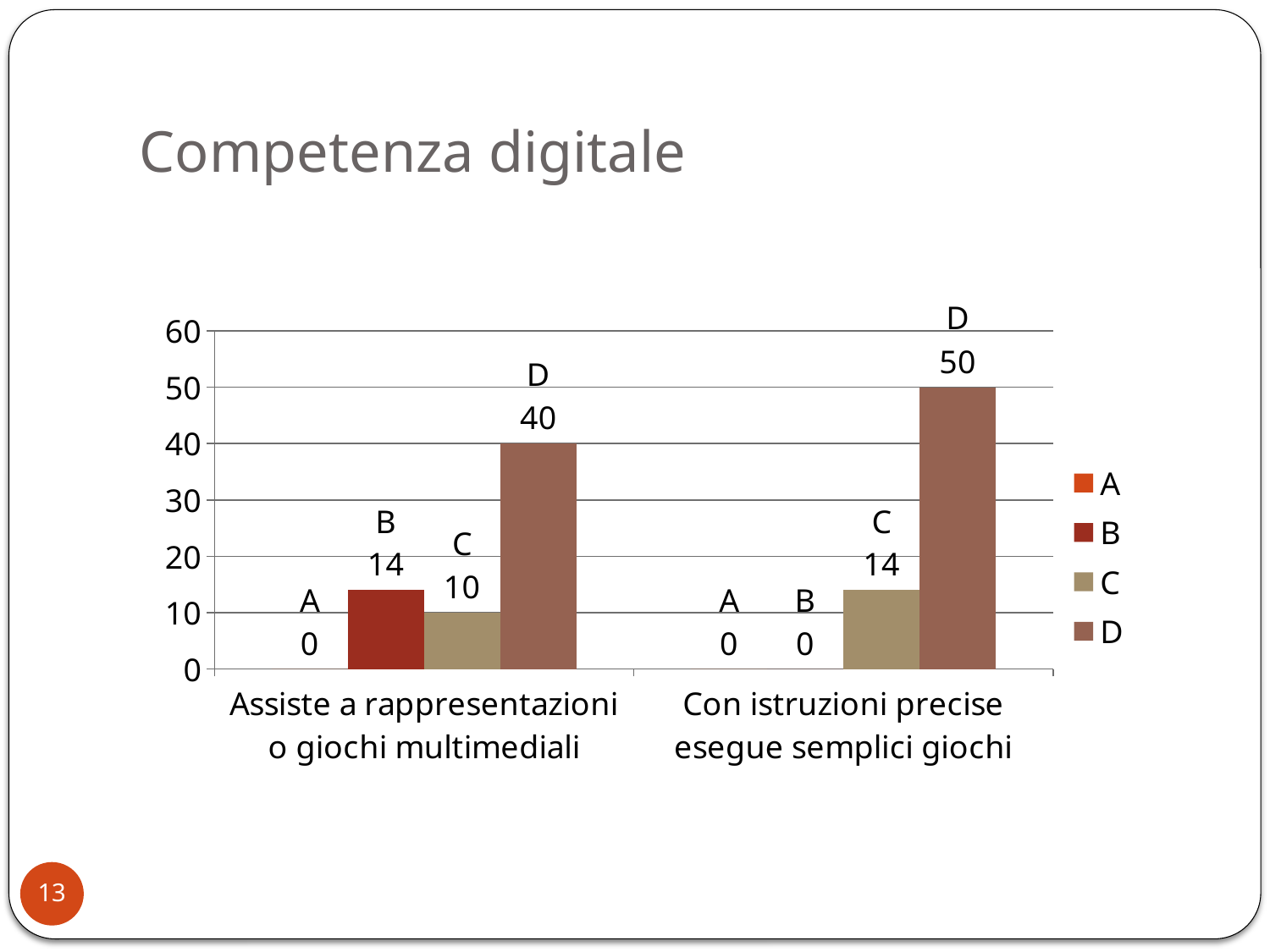
How many series does the legend list? 4 What is the value for series C in the category "Con istruzioni precise esegue semplici giochi"? 14 What is the title of the slide? Competenza digitale Which series has the highest value in the category "Con istruzioni precise esegue semplici giochi"? D What is the value for series D in the category "Assiste a rappresentazioni o giochi multimediali"? 40 What kind of chart is shown on the slide? bar chart Is the value for D in "Con istruzioni precise esegue semplici giochi" greater or less than 30? greater What is the difference between the C values of the two categories? 4 How many categories are shown on the x axis? 2 What is the difference between the D values of the two categories? 10 Which is larger in the category "Assiste a rappresentazioni o giochi multimediali": the value for B or the value for C? B What is the value for series B in the category "Assiste a rappresentazioni o giochi multimediali"? 14